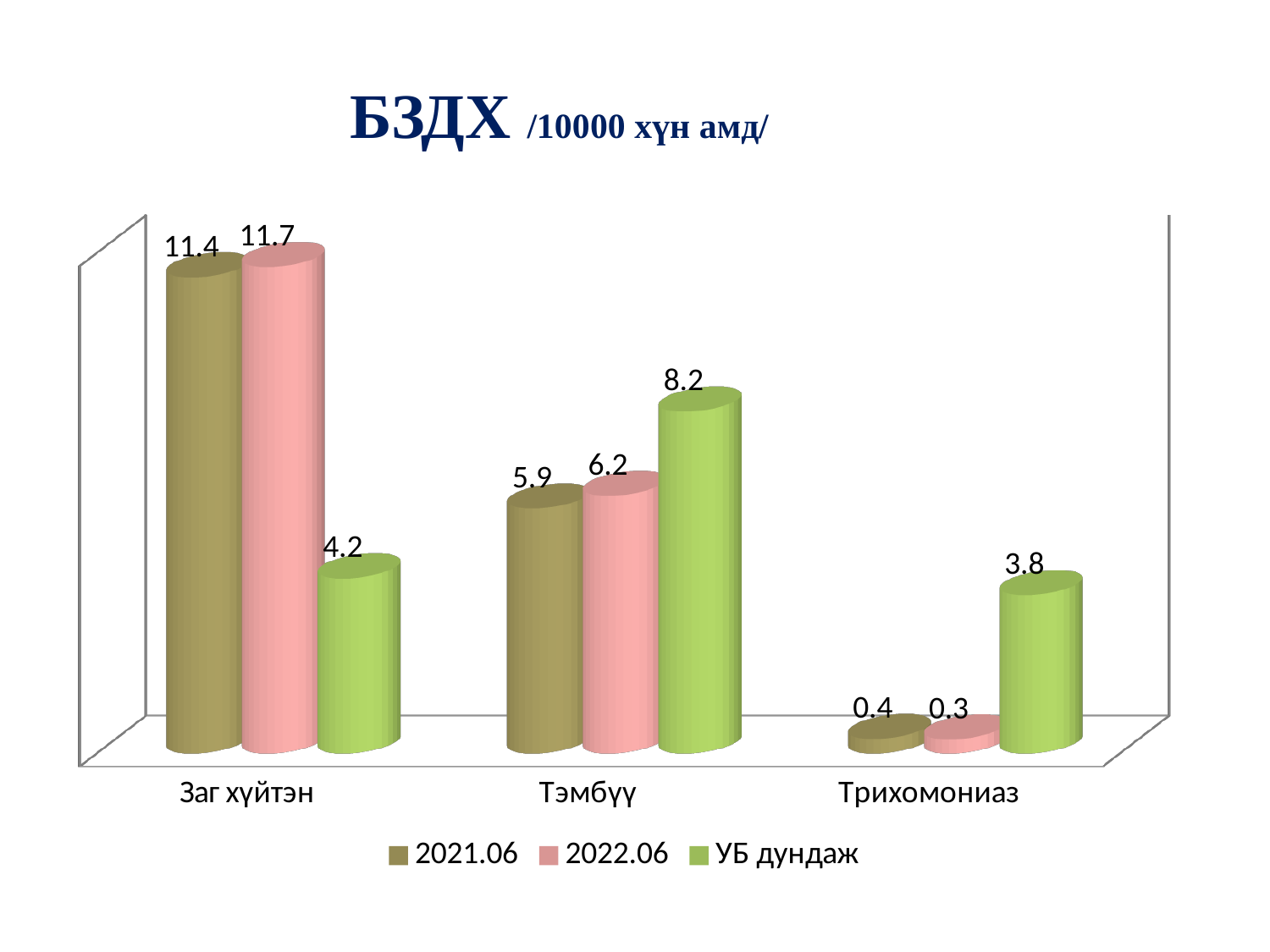
Which is larger for Тэмбүү: the 2021.06 value or the УБ дундаж value? УБ дундаж What is the title of the chart? БЗДХ /10000 хүн амд/ What is the difference between the 2022.06 value and the УБ дундаж value for Заг хүйтэн? 7.5 Which category has the highest value in the 2022.06 series? Заг хүйтэн What is the difference between the 2022.06 and 2021.06 values for Тэмбүү? 0.3 What kind of chart is shown on the slide? Bar chart What is the value for Тэмбүү in the УБ дундаж series? 8.2 How many series does the legend list? 3 How many categories are shown on the x axis? 3 What is the value for Трихомониаз in the 2022.06 series? 0.3 What is the value for Заг хүйтэн in the 2021.06 series? 11.4 Which category has the lowest value in the УБ дундаж series? Трихомониаз